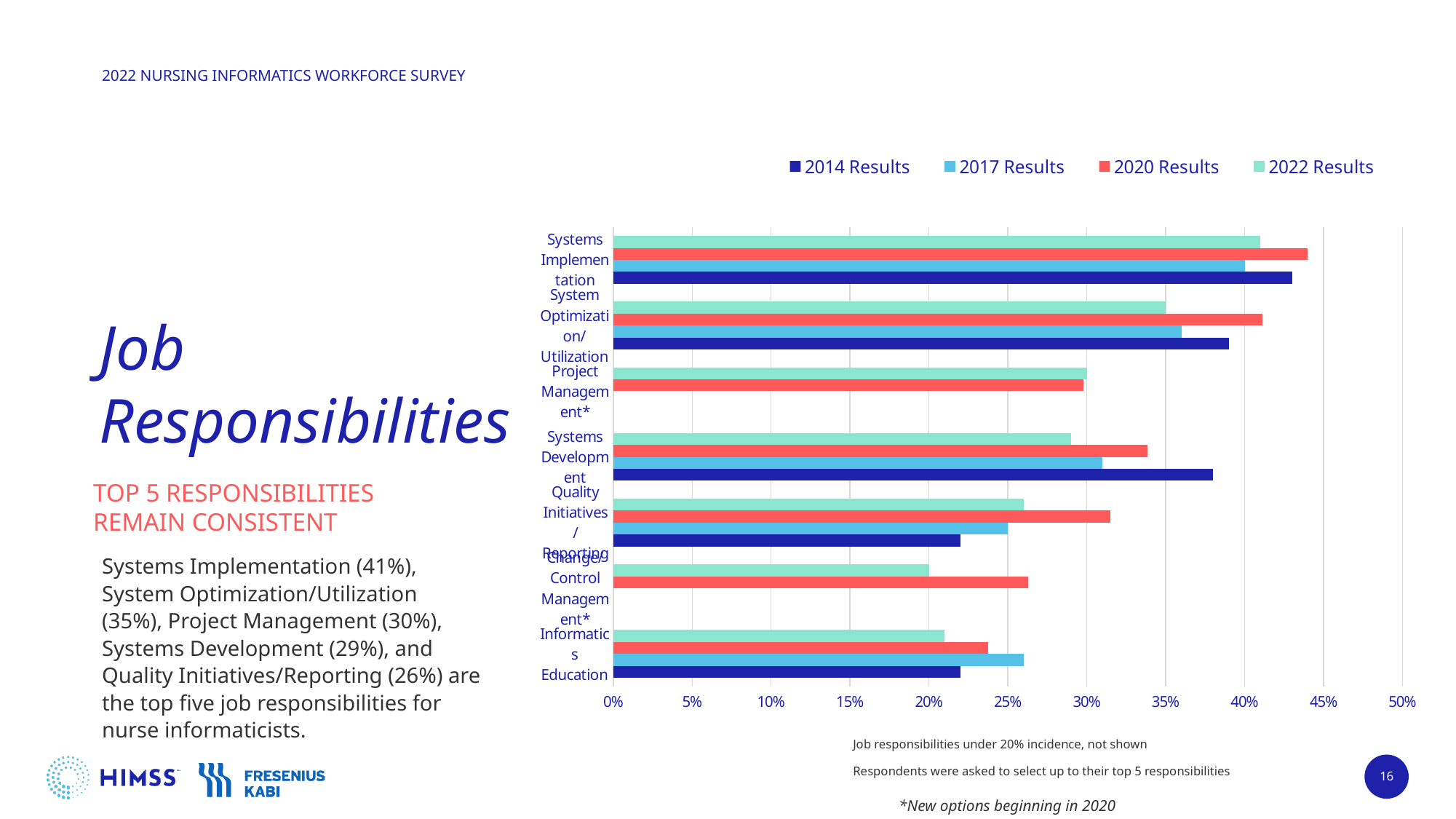
Is the 2014 Results value for Systems Implementation greater or less than 40%? greater How many series does the legend list? 4 What is the 2022 Results value for Quality Initiatives/Reporting? 26% What is the difference between the 2022 Results values for Systems Implementation and System Optimization/Utilization? 6% What kind of chart is shown on the slide? Bar chart Which series is shown in red in the legend? 2020 Results What is the 2022 Results value for Systems Implementation? 41% What is the 2022 Results value for Project Management? 30% Is the 2014 Results value for Quality Initiatives/Reporting greater or less than 25%? less How many job responsibility categories are plotted on the chart? 7 Which category has the highest 2022 Results value? Systems Implementation For Systems Development, which is larger: the 2014 Results value or the 2017 Results value? 2014 Results